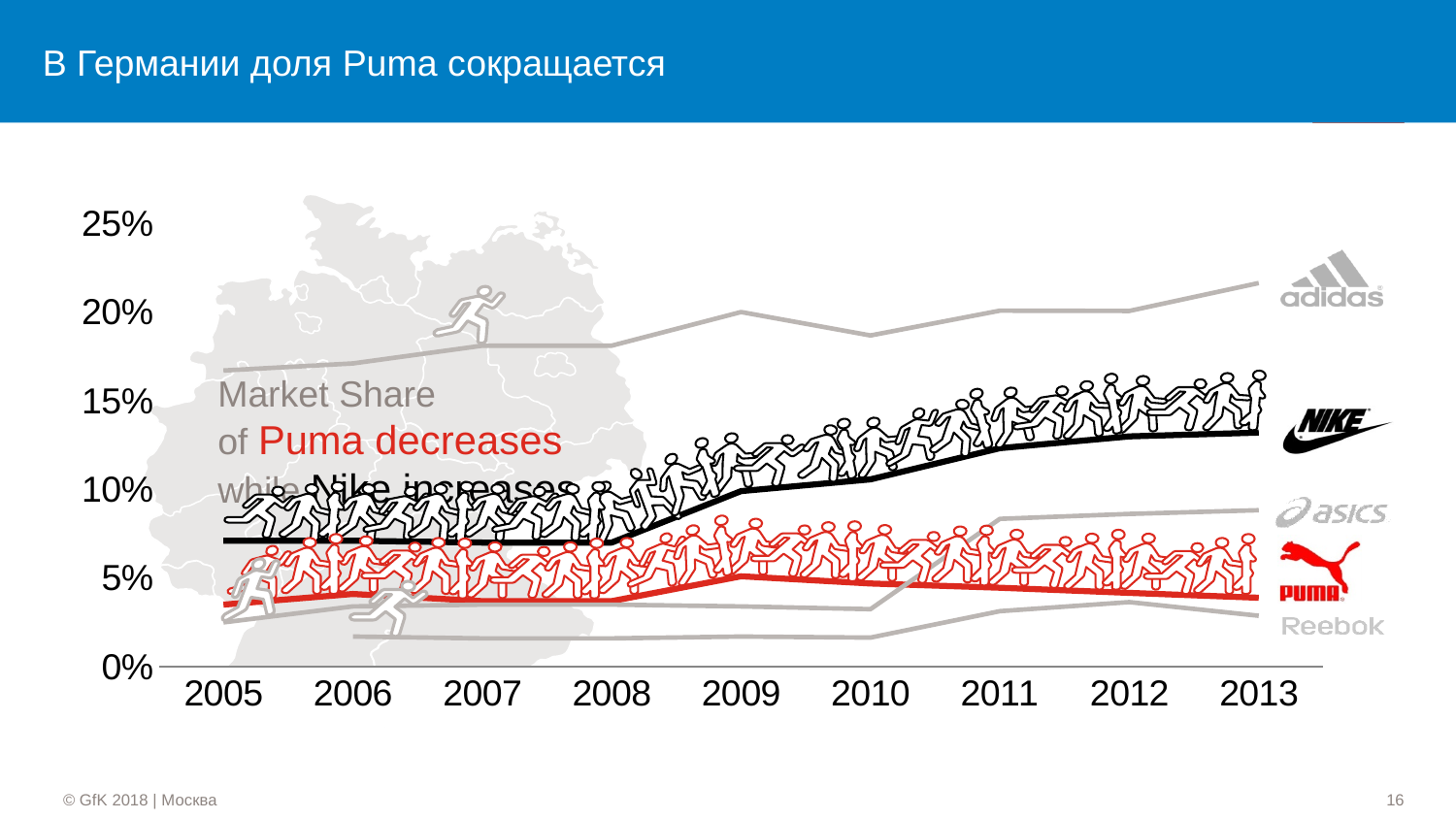
What colour is the line representing Puma on the chart? red What kind of chart is shown on the slide? line chart Does the market share of Puma rise or fall from 2009 to 2013? fall Is the market share of adidas in 2013 greater or less than 20%? greater In 2013, which brand has the larger market share, Nike or Puma? Nike Which brand has the highest market share in 2013? adidas How many brands are plotted as lines on the chart? 5 Does the market share of Nike rise or fall from 2005 to 2013? rise Is the market share of Puma in 2013 greater or less than 5%? less Is the market share of Nike in 2005 greater or less than 10%? less How many years are shown along the x axis of the chart? 9 Which brand has the lowest market share in 2013? Reebok